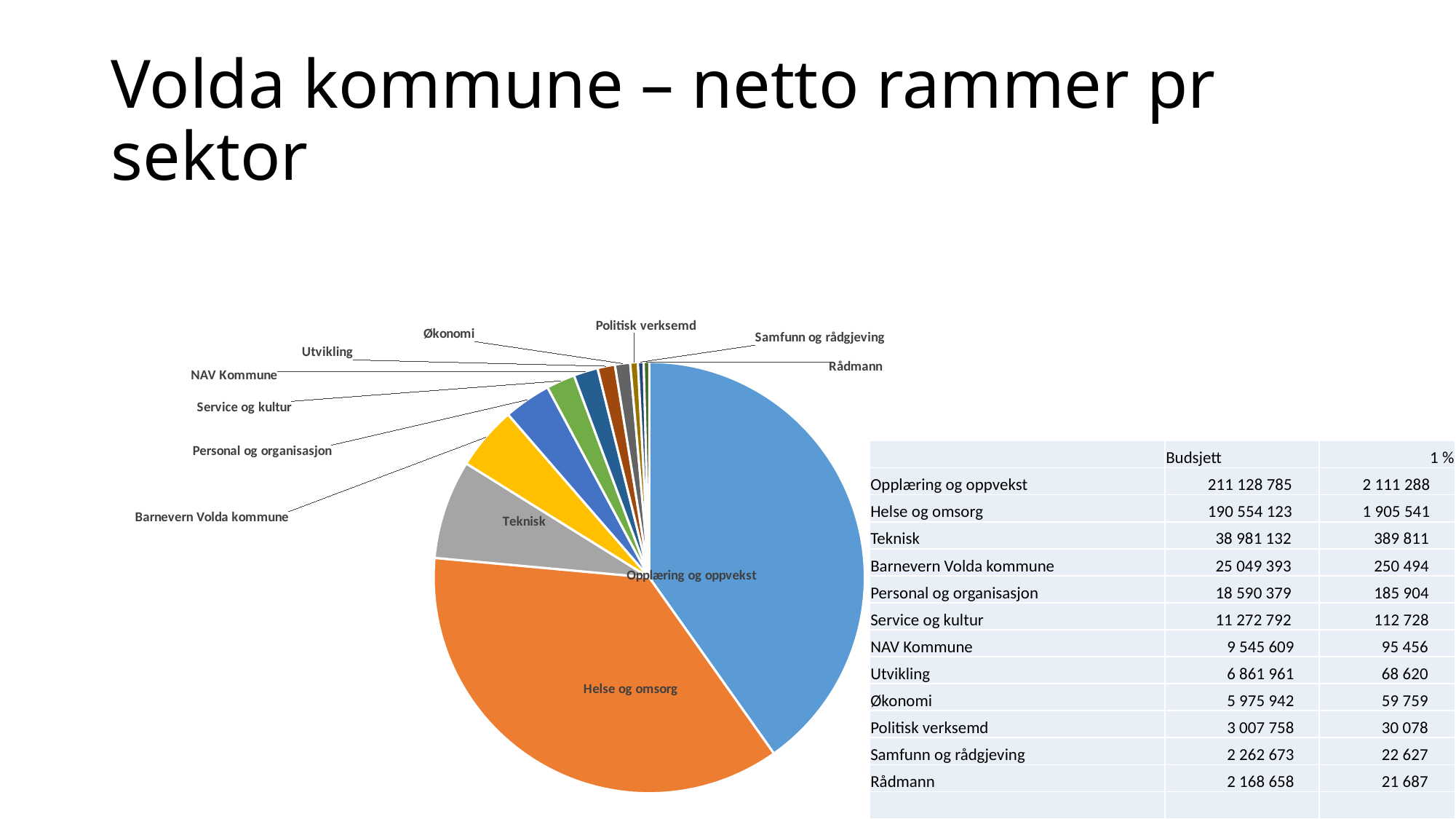
What kind of chart is shown on the slide? pie chart Which is larger in the pie chart, Helse og omsorg or Teknisk? Helse og omsorg What is the Budsjett value for Helse og omsorg? 190 554 123 How many sectors (slices) does the pie chart show? 12 What is the title of the slide containing the pie chart? Volda kommune – netto rammer pr sektor What is the Budsjett value for Rådmann? 2 168 658 What is the Budsjett value for Teknisk? 38 981 132 What is the difference in Budsjett between Opplæring og oppvekst and Helse og omsorg? 20 574 662 What colour is the Helse og omsorg slice in the pie chart? orange What is the Budsjett value for NAV Kommune? 9 545 609 Which is larger, the slice for Teknisk or the slice for Barnevern Volda kommune? Teknisk Which sector has the largest slice in the pie chart? Opplæring og oppvekst